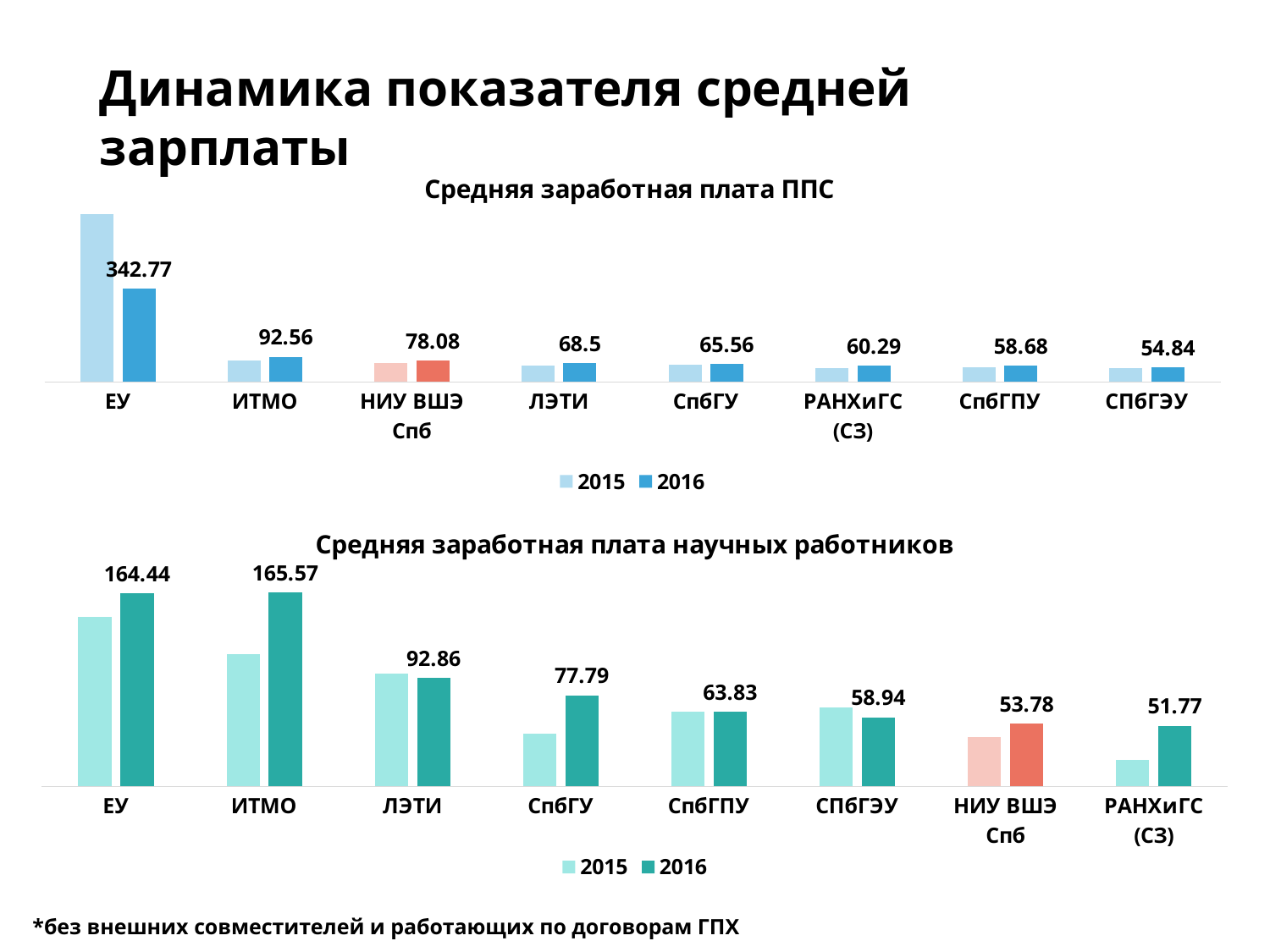
In the top chart (Средняя заработная плата ППС), what value is labelled for ИТМО? 92.56 In the top chart (Средняя заработная плата ППС), what is the difference between the labelled values for ИТМО and НИУ ВШЭ Спб? 14.48 How many categories are shown on the x axis of the top chart (Средняя заработная плата ППС)? 8 In the top chart (Средняя заработная плата ППС), which category has the lowest labelled value? СПбГЭУ In the bottom chart (Средняя заработная плата научных работников), which category has the highest labelled value? ИТМО In the top chart (Средняя заработная плата ППС), which bar is taller for ЕУ: 2015 or 2016? 2015 In the bottom chart (Средняя заработная плата научных работников), which bar is taller for ИТМО: 2015 or 2016? 2016 In the bottom chart (Средняя заработная плата научных работников), what value is labelled for РАНХиГС (СЗ)? 51.77 In the bottom chart (Средняя заработная плата научных работников), what is the difference between the labelled values for ИТМО and ЕУ? 1.13 In the top chart (Средняя заработная плата ППС), what value is labelled for ЕУ? 342.77 How many series does the legend of the bottom chart (Средняя заработная плата научных работников) list? 2 In the bottom chart (Средняя заработная плата научных работников), what value is labelled for ЛЭТИ? 92.86